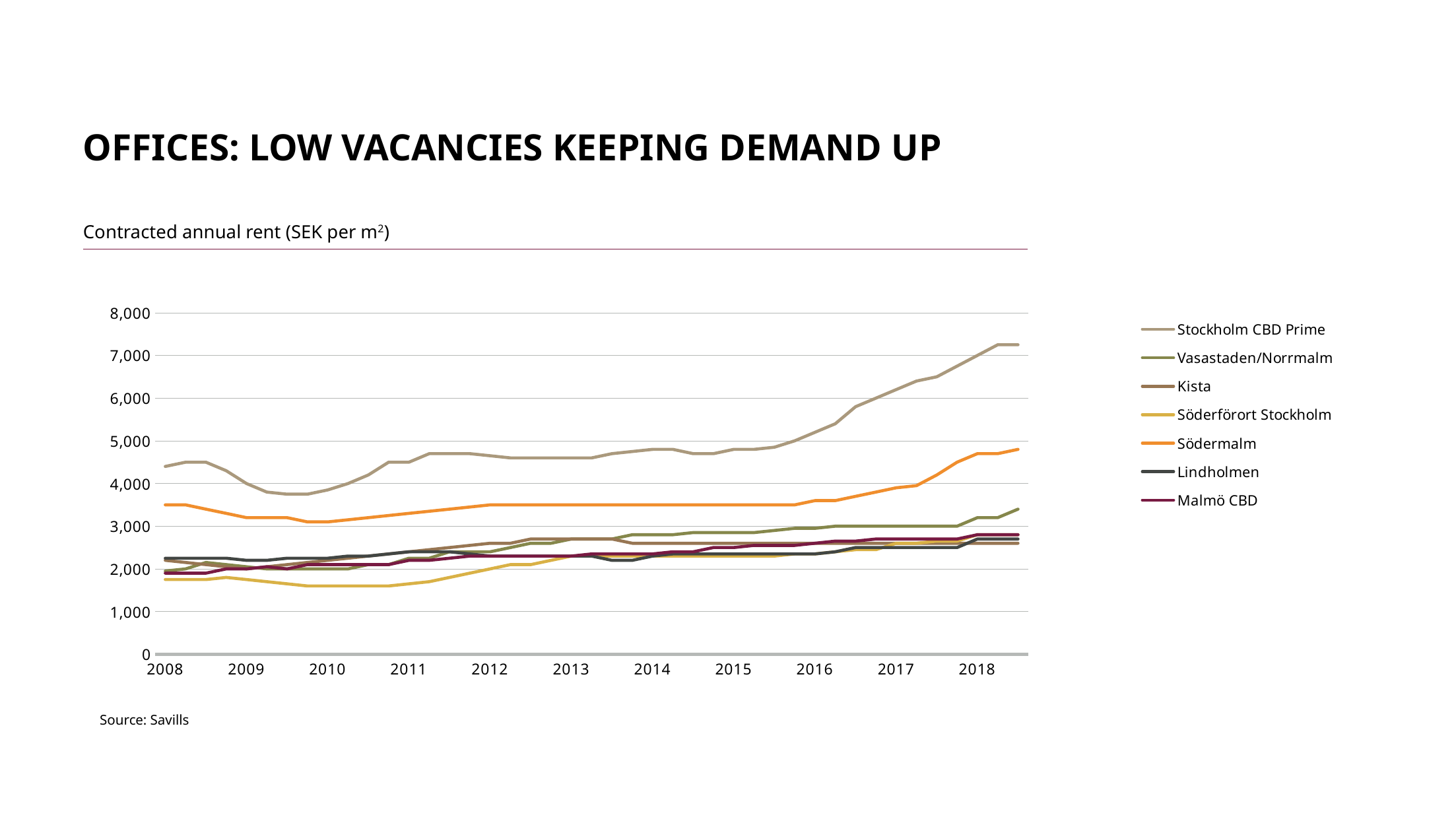
How many years are labelled on the x axis? 11 What kind of chart is shown on the slide? Line chart Does the Stockholm CBD Prime line rise or fall between 2015 and 2018? Rise Does the Söderförort Stockholm line rise or fall between 2008 and 2010? Fall Is the value for Södermalm in 2018 greater or less than 4,000? greater How many series does the legend list? 7 Is the value for Stockholm CBD Prime at the end of 2018 greater or less than 7,000? greater Which series has the highest contracted annual rent in 2018? Stockholm CBD Prime Is the value for Söderförort Stockholm in 2010 greater or less than 2,000? less Which is larger in 2018, the value for Södermalm or the value for Kista? Södermalm What unit is the contracted annual rent measured in, according to the chart subtitle? SEK per m²